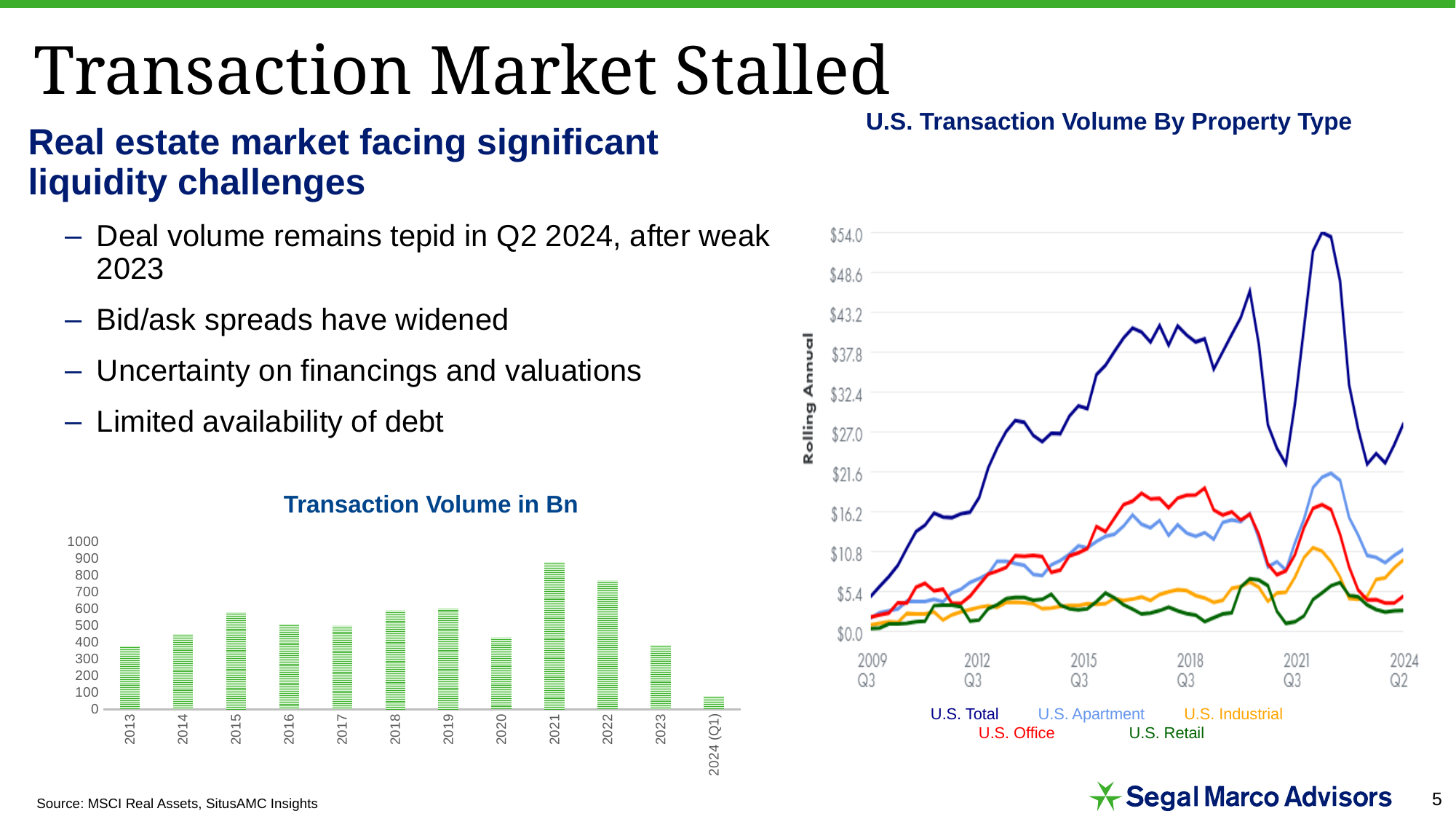
In the 'U.S. Transaction Volume By Property Type' chart, which series has the highest values throughout the period? U.S. Total In the 'Transaction Volume in Bn' chart, is the value for 2021 greater or less than 800? greater In the 'Transaction Volume in Bn' chart, which is larger, the value for 2021 or the value for 2022? 2021 What kind of chart is the 'U.S. Transaction Volume By Property Type' chart? line chart In the 'Transaction Volume in Bn' chart, how many years/periods are shown on the x axis? 12 In the 'Transaction Volume in Bn' chart, is the value for 2024 (Q1) greater or less than 100? less In the 'Transaction Volume in Bn' chart, which period has the lowest transaction volume? 2024 (Q1) What kind of chart is the 'Transaction Volume in Bn' chart? bar chart In the 'U.S. Transaction Volume By Property Type' chart, does the U.S. Total line rise or fall between 2009 Q3 and 2012 Q3? rise In the 'Transaction Volume in Bn' chart, which period has the highest transaction volume? 2021 How many series does the legend of the 'U.S. Transaction Volume By Property Type' chart list? 5